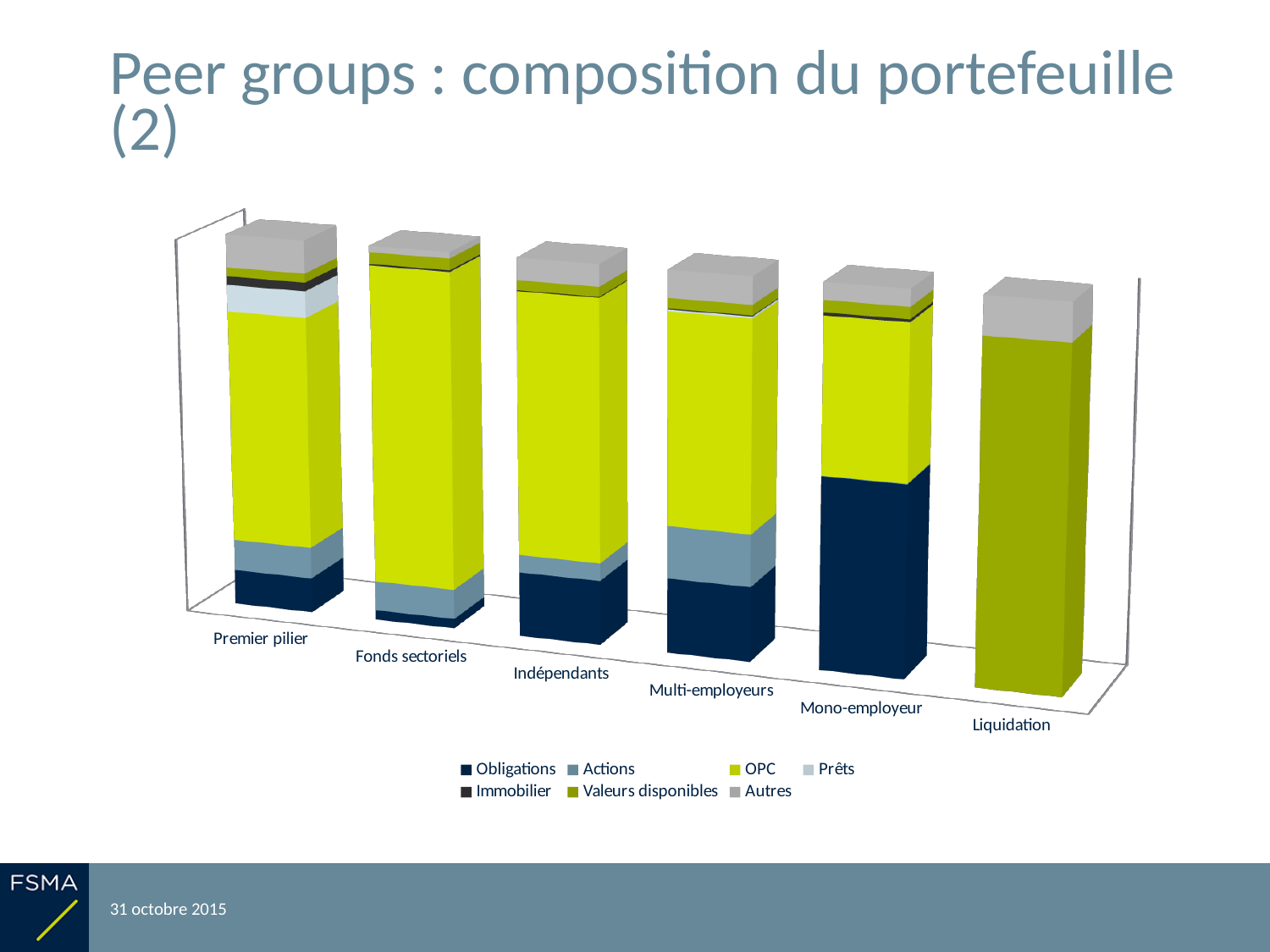
Which category has the largest Obligations segment in its bar? Mono-employeur What is the title of the slide containing the chart? Peer groups : composition du portefeuille (2) Is the Actions segment larger for Multi-employeurs or for Fonds sectoriels? Multi-employeurs Which category has the largest OPC segment in its bar? Fonds sectoriels Is the OPC segment larger for Fonds sectoriels or for Mono-employeur? Fonds sectoriels Which category's bar is made up almost entirely of Valeurs disponibles? Liquidation Which category is the only one with a clearly visible Prêts segment? Premier pilier Which category has the smallest Obligations segment among the bars that show one? Fonds sectoriels How many series does the chart's legend list? 7 Is the Obligations segment larger for Mono-employeur or for Premier pilier? Mono-employeur How many peer group categories are shown along the x axis of the chart? 6 What kind of chart is shown on the slide? Stacked bar chart